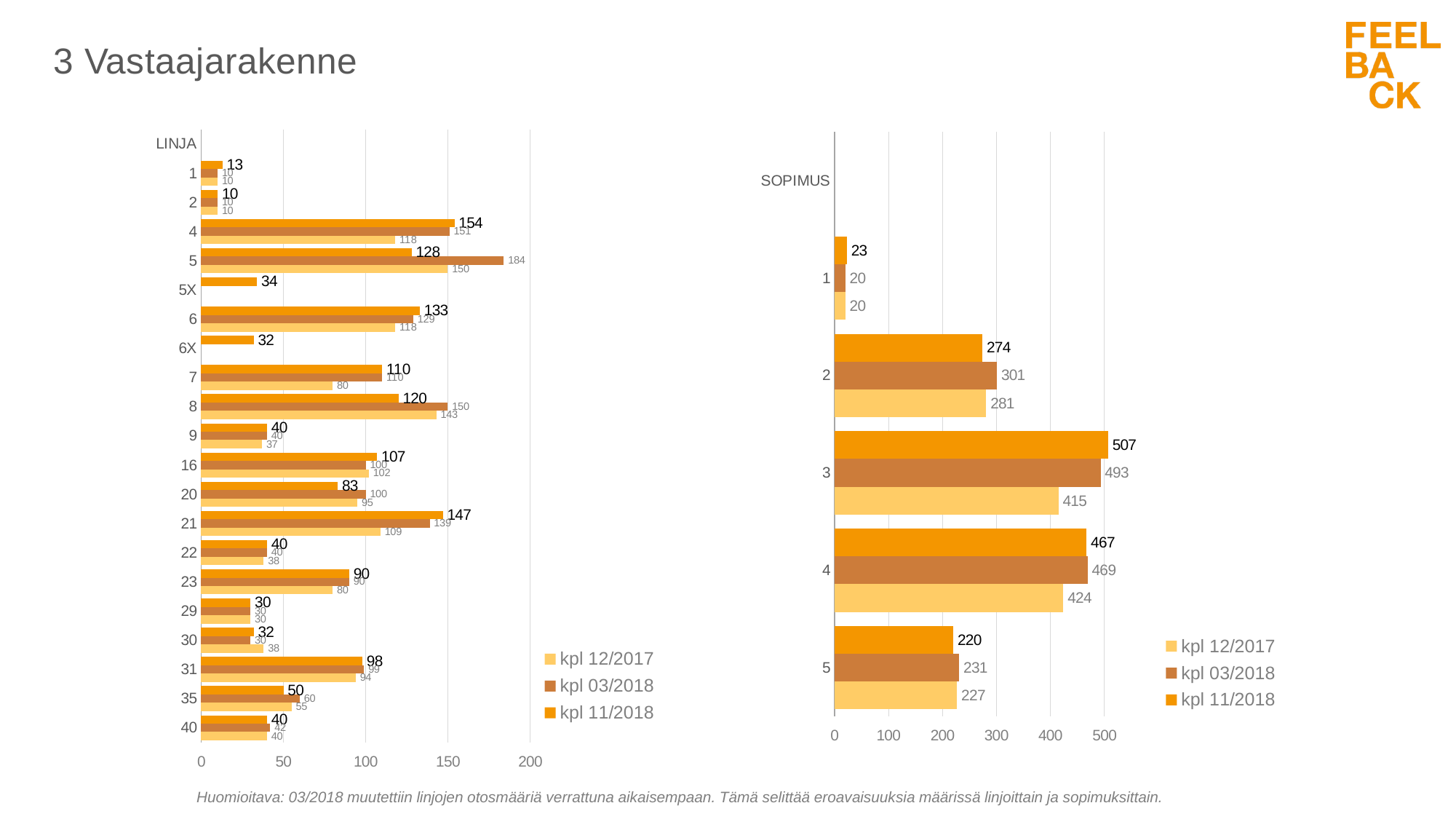
In the SOPIMUS chart on the right, which sopimus has the lowest kpl 03/2018 value? 1 In the SOPIMUS chart on the right, what is the difference between the kpl 03/2018 and kpl 12/2017 values for sopimus 3? 78 In the SOPIMUS chart on the right, which sopimus has the highest kpl 11/2018 value? 3 In the LINJA chart on the left, which is larger for linja 8: the kpl 03/2018 value or the kpl 11/2018 value? kpl 03/2018 How many series does the legend of the LINJA chart on the left list? 3 In the SOPIMUS chart on the right, what is the kpl 11/2018 value for sopimus 3? 507 In the LINJA chart on the left, what is the kpl 03/2018 value for linja 5? 184 What type of chart is the SOPIMUS chart on the right? Bar chart In the LINJA chart on the left, what is the kpl 11/2018 value for linja 21? 147 How many sopimus categories are shown in the SOPIMUS chart on the right? 5 In the LINJA chart on the left, what is the kpl 11/2018 value for linja 5X? 34 In the SOPIMUS chart on the right, what is the kpl 12/2017 value for sopimus 4? 424